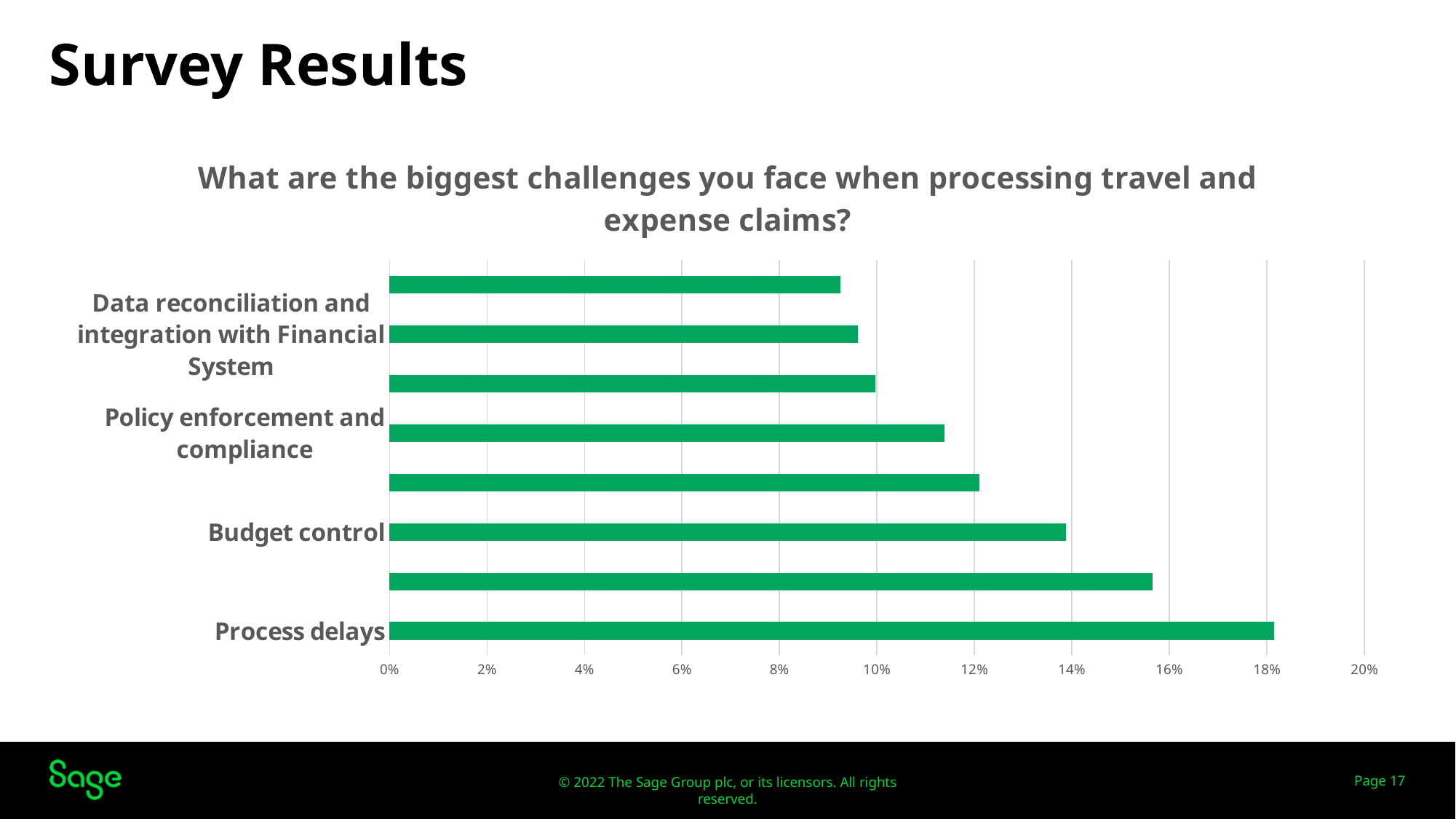
What kind of chart is shown on the slide? bar chart Is the value for Process delays greater or less than 16%? greater How many bars are plotted in the chart? 8 Which labelled category has the longest bar in the chart? Process delays Is the value for Process delays greater or less than 20%? less Is the value for Data reconciliation and integration with Financial System greater or less than 12%? less Which is larger, the value for Process delays or the value for Budget control? Process delays Which is larger, the value for Policy enforcement and compliance or the value for Data reconciliation and integration with Financial System? Policy enforcement and compliance What is the highest value shown on the chart's horizontal axis? 20%